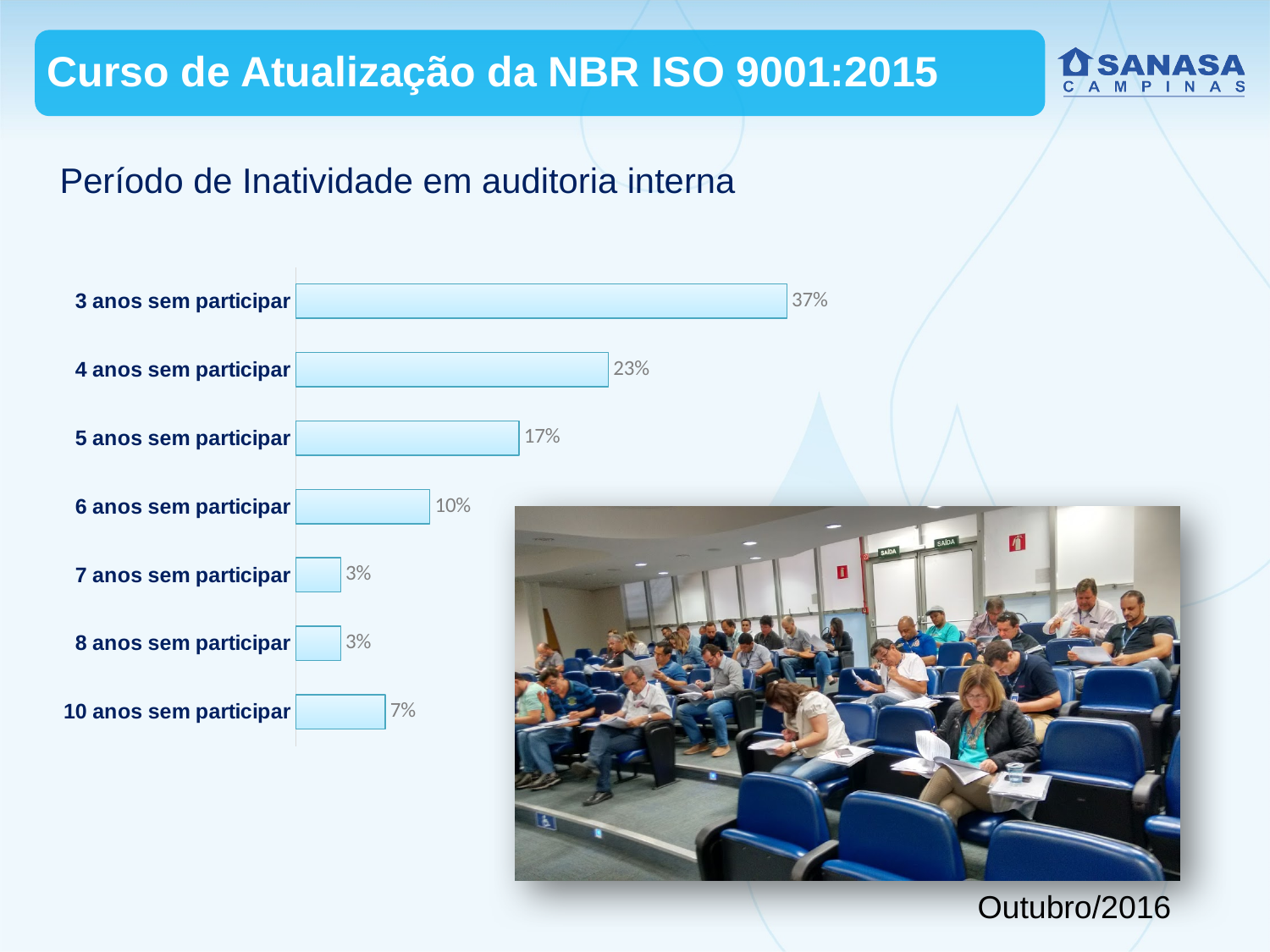
What is the value for "6 anos sem participar"? 10% What is the value for "3 anos sem participar"? 37% What is the value for "10 anos sem participar"? 7% Which category has the highest value? 3 anos sem participar Which is larger, the value for "10 anos sem participar" or "7 anos sem participar"? 10 anos sem participar What is the title of the chart? Período de Inatividade em auditoria interna What kind of chart is shown on the slide? Bar chart How many categories are shown in the chart? 7 What is the difference between the values for "6 anos sem participar" and "10 anos sem participar"? 3% Which is larger, the value for "4 anos sem participar" or "5 anos sem participar"? 4 anos sem participar What is the difference between the values for "3 anos sem participar" and "4 anos sem participar"? 14% What is the value for "5 anos sem participar"? 17%